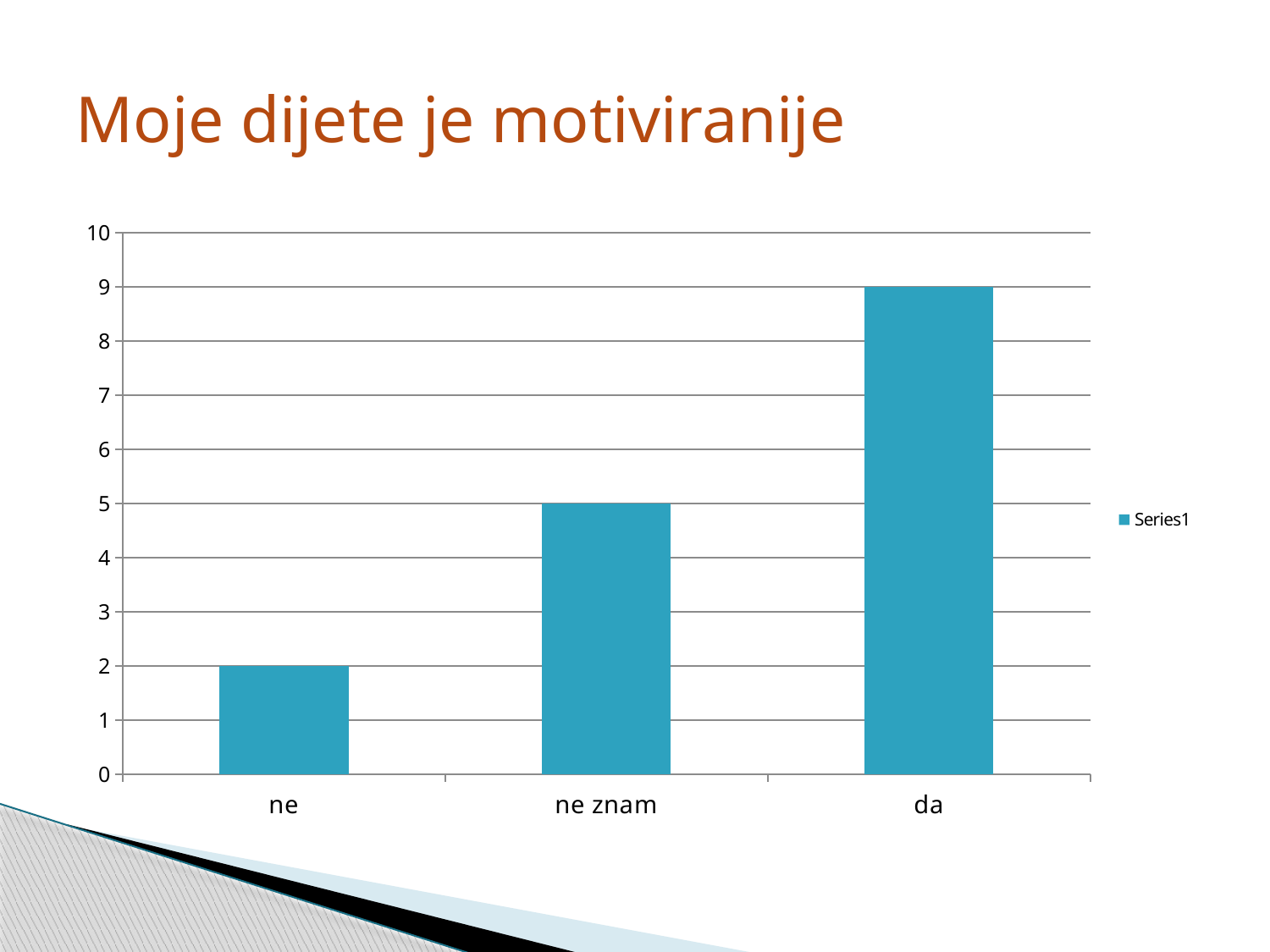
What is the value for "da"? 9 What is the difference between the values for "ne znam" and "ne"? 3 Which category has the highest value? da Which category has the lowest value? ne What is the name of the series listed in the legend? Series1 How many categories are shown on the x axis? 3 What is the value for "ne"? 2 Is the value for "da" greater or less than 8? greater Which is larger, the value for "ne znam" or the value for "da"? da What is the difference between the values for "da" and "ne"? 7 What kind of chart is shown on the slide? bar chart What is the value for "ne znam"? 5